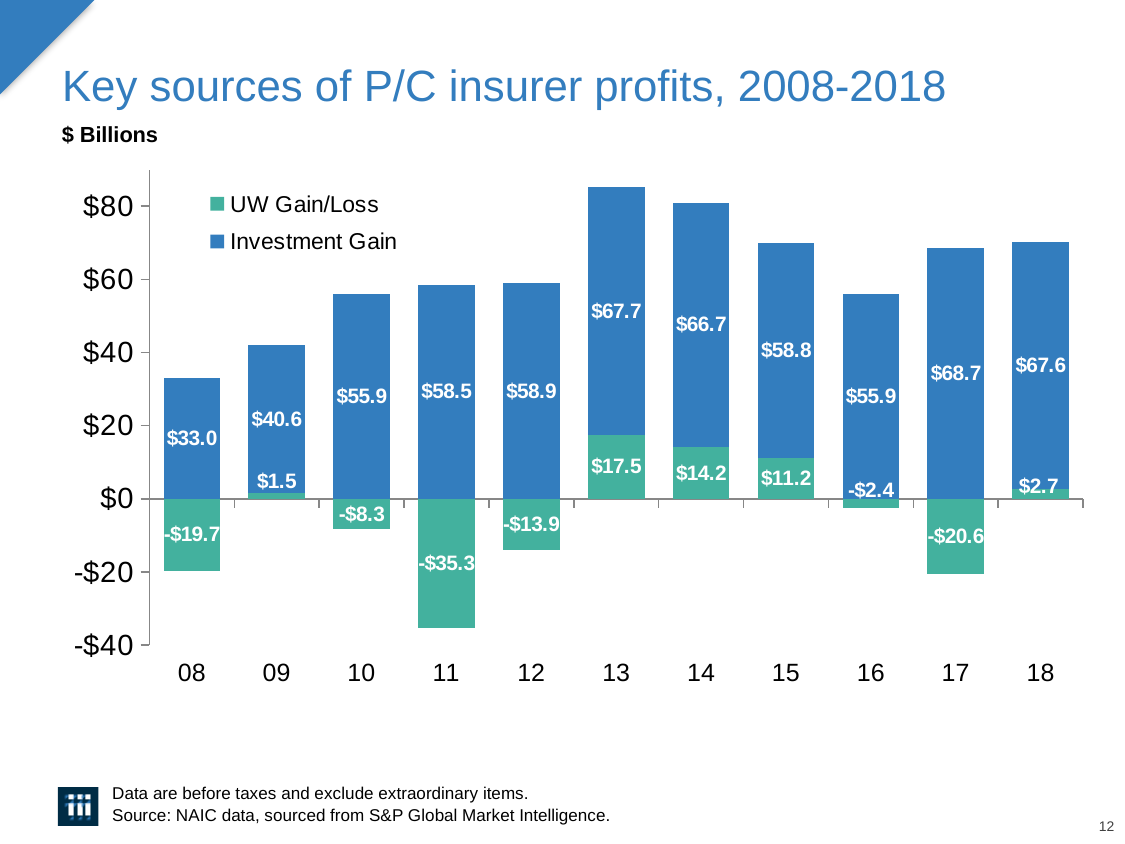
Which year has the highest Investment Gain? 17 Which year has the lowest UW Gain/Loss? 11 What is the UW Gain/Loss value for 2018? $2.7 Which year has the highest UW Gain/Loss? 13 What kind of chart is shown on the slide? Stacked bar chart Is the Investment Gain larger in 2014 or in 2015? 2014 What is the difference between the Investment Gain in 2017 and in 2013? $1.0 What is the UW Gain/Loss value for 2011? -$35.3 How many series does the legend list? 2 What is the Investment Gain value for 2013? $67.7 What is the total of the stacked bar for 2013 (UW Gain/Loss plus Investment Gain)? $85.2 How many years are shown on the x axis? 11